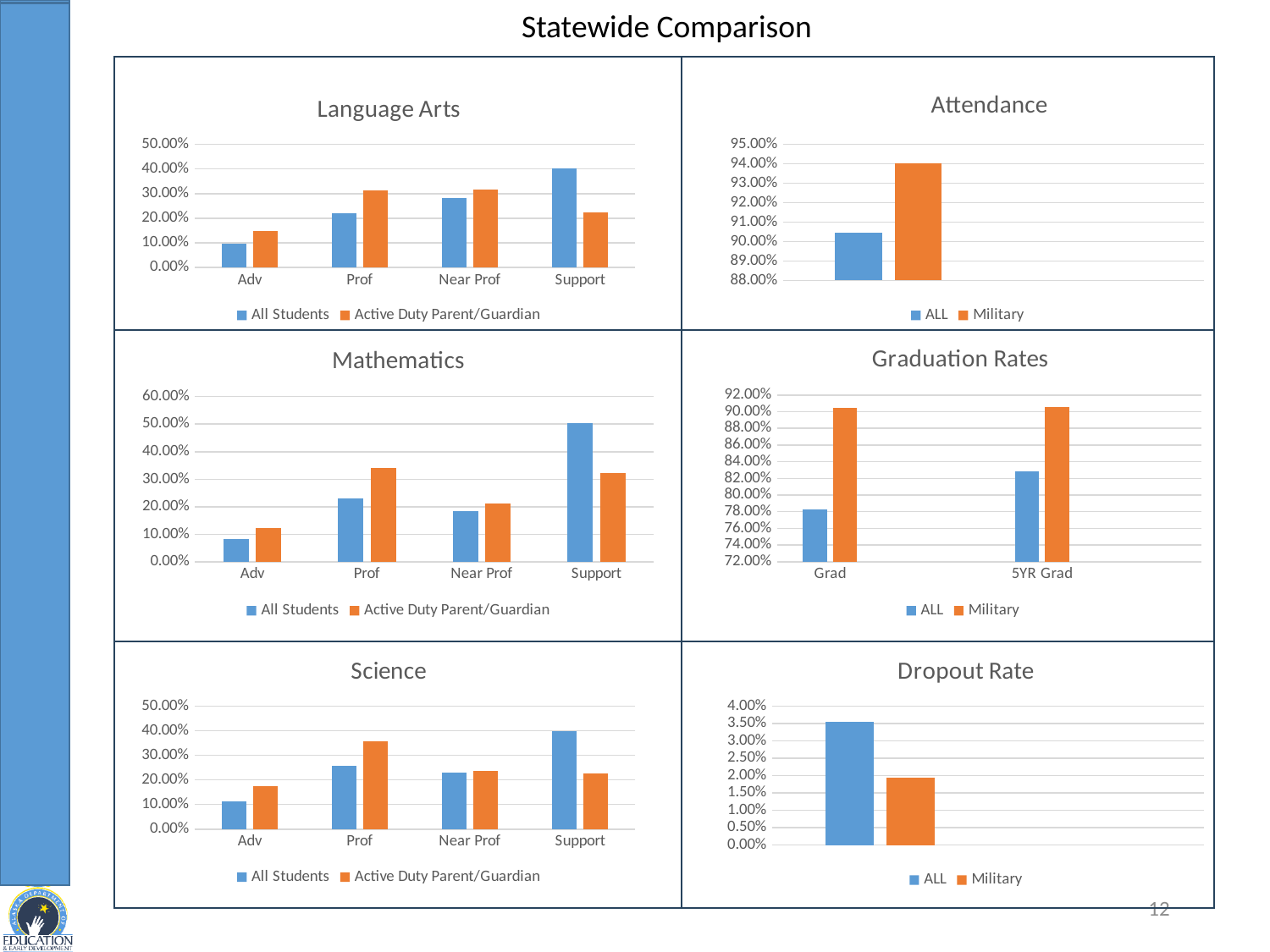
In the Attendance chart, which is larger, ALL or Military? Military What are the two legend entries in the Attendance chart? ALL and Military How many categories are shown on the x axis of the Graduation Rates chart? 2 What kind of chart is the Language Arts chart? bar chart In the Science chart, which category has the lowest value for All Students? Adv In the Language Arts chart, is the All Students value for Support greater or less than 30.00%? greater How many series does the legend of the Science chart list? 2 How many categories are shown on the x axis of the Language Arts chart? 4 In the Mathematics chart, which category has the highest value for All Students? Support In the Mathematics chart, for Prof, which is larger, All Students or Active Duty Parent/Guardian? Active Duty Parent/Guardian In the Dropout Rate chart, is the value for ALL greater or less than 3.00%? greater In the Graduation Rates chart, is the ALL value for Grad greater or less than 80.00%? less